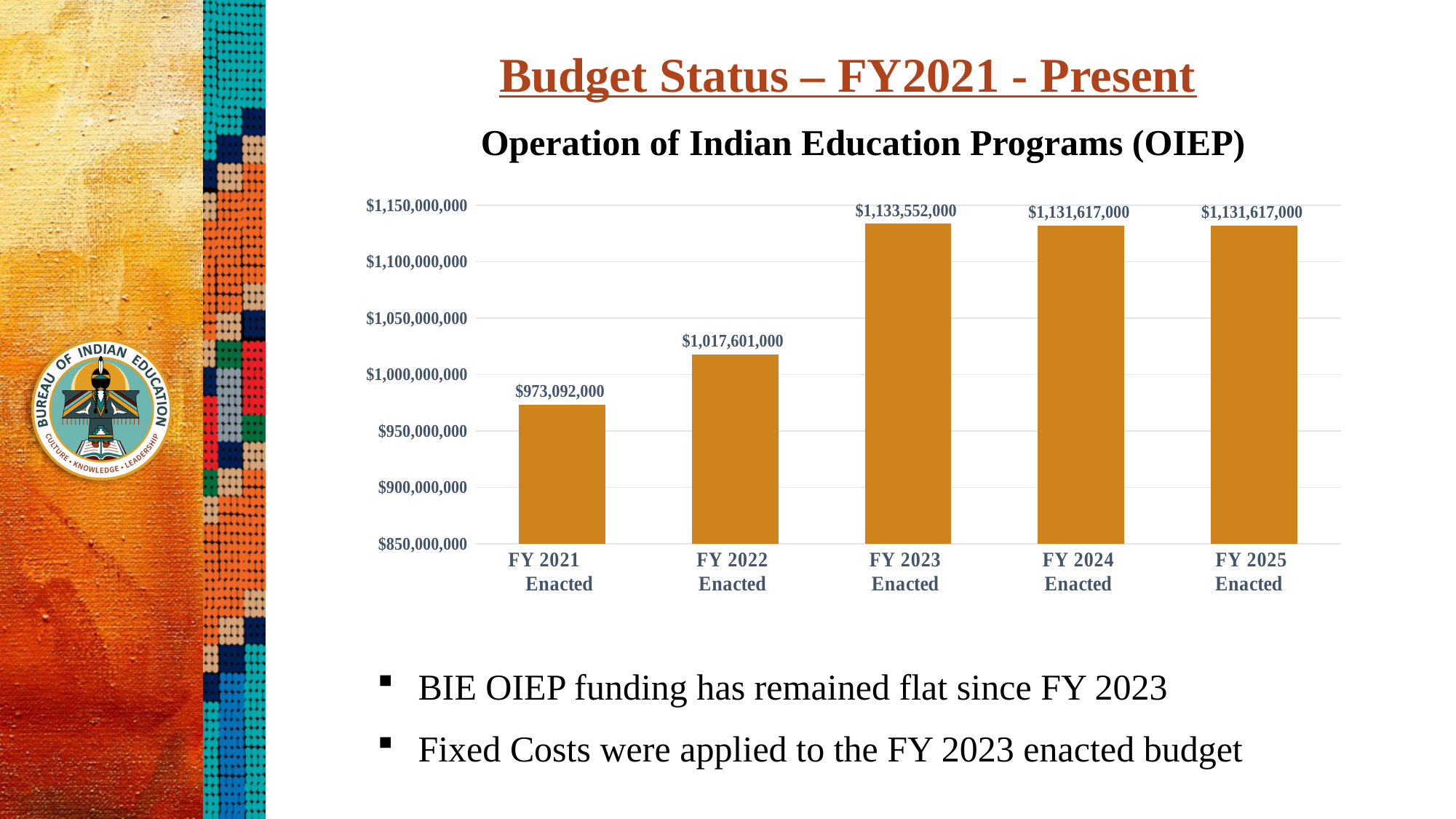
What is the value for FY 2021 Enacted? $973,092,000 What is the value for FY 2025 Enacted? $1,131,617,000 Which fiscal year has the highest enacted value? FY 2023 Enacted Is the value for FY 2021 Enacted greater or less than $1,000,000,000? less Which fiscal year has the lowest enacted value? FY 2021 Enacted What kind of chart is shown on the slide? bar chart What is the difference between the FY 2022 Enacted and FY 2021 Enacted values? $44,509,000 What is the difference between the FY 2023 Enacted and FY 2022 Enacted values? $115,951,000 Which is larger, the FY 2021 Enacted value or the FY 2022 Enacted value? FY 2022 Enacted Do the values rise or fall from FY 2021 Enacted to FY 2023 Enacted? rise What is the value for FY 2023 Enacted? $1,133,552,000 How many fiscal years are shown on the chart? 5